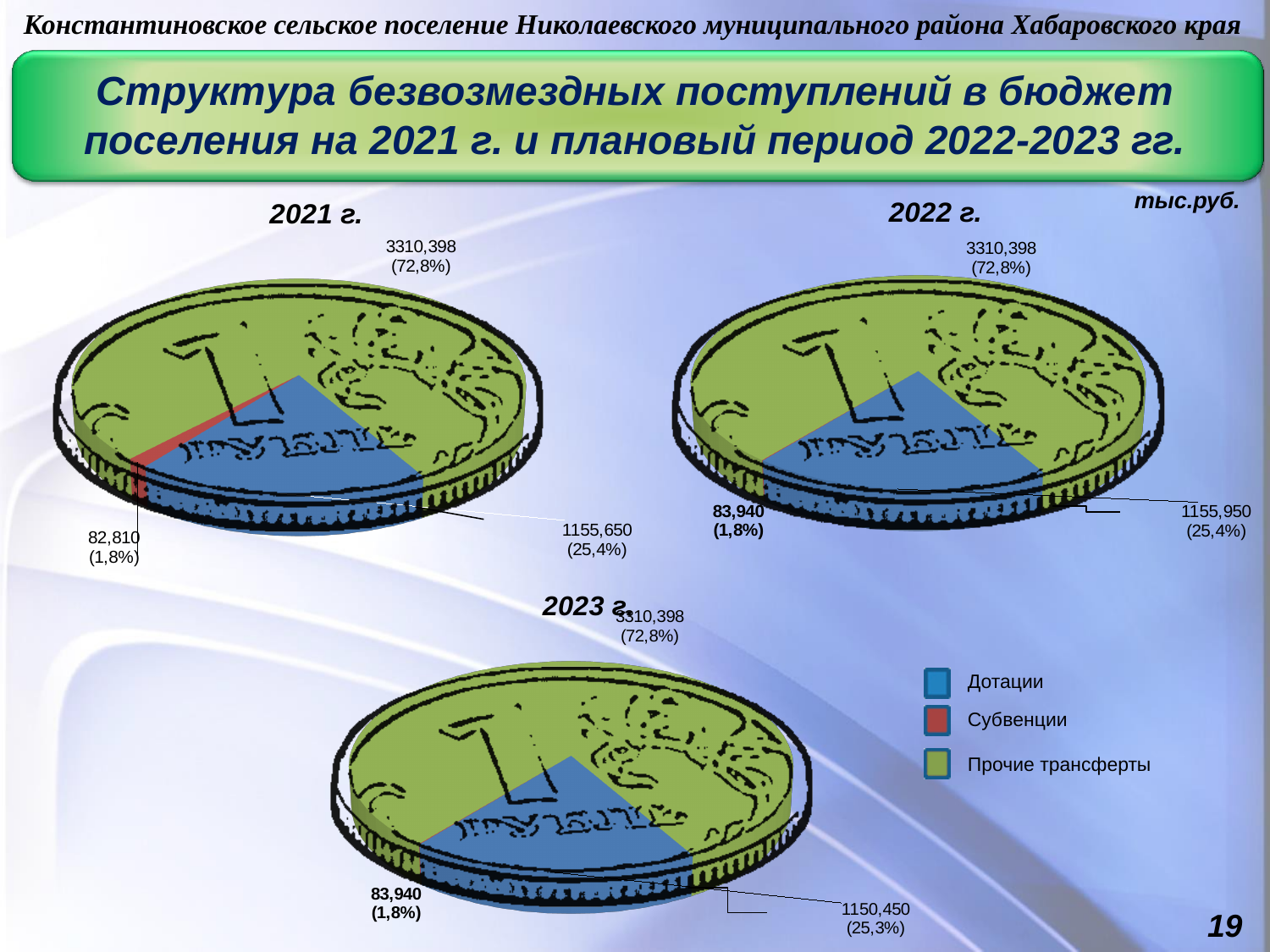
In the 2021 г. chart, what is the difference between the largest slice (3310,398) and the slice of 1155,650? 2154,748 How many pie charts are shown on the slide? 3 In the 2023 г. chart, what is the value of the slice with share 1,8%? 83,940 What type of chart is used for the 2021 г. chart? pie chart Which legend entry is shown in red? Субвенции In the 2022 г. chart, what is the value of the slice labelled 25,4%? 1155,950 In the 2021 г. chart, what share of the pie does the largest slice take? 72,8% In the 2021 г. chart, what is the value of the smallest slice? 82,810 In the 2021 г. chart, what is the value of the largest slice? 3310,398 How many categories does the legend list? 3 Which is larger: the 1155,650 slice in the 2021 г. chart or the 1150,450 slice in the 2023 г. chart? 1155,650 in the 2021 г. chart In the 2023 г. chart, what share of the pie does the slice with value 1150,450 take? 25,3%